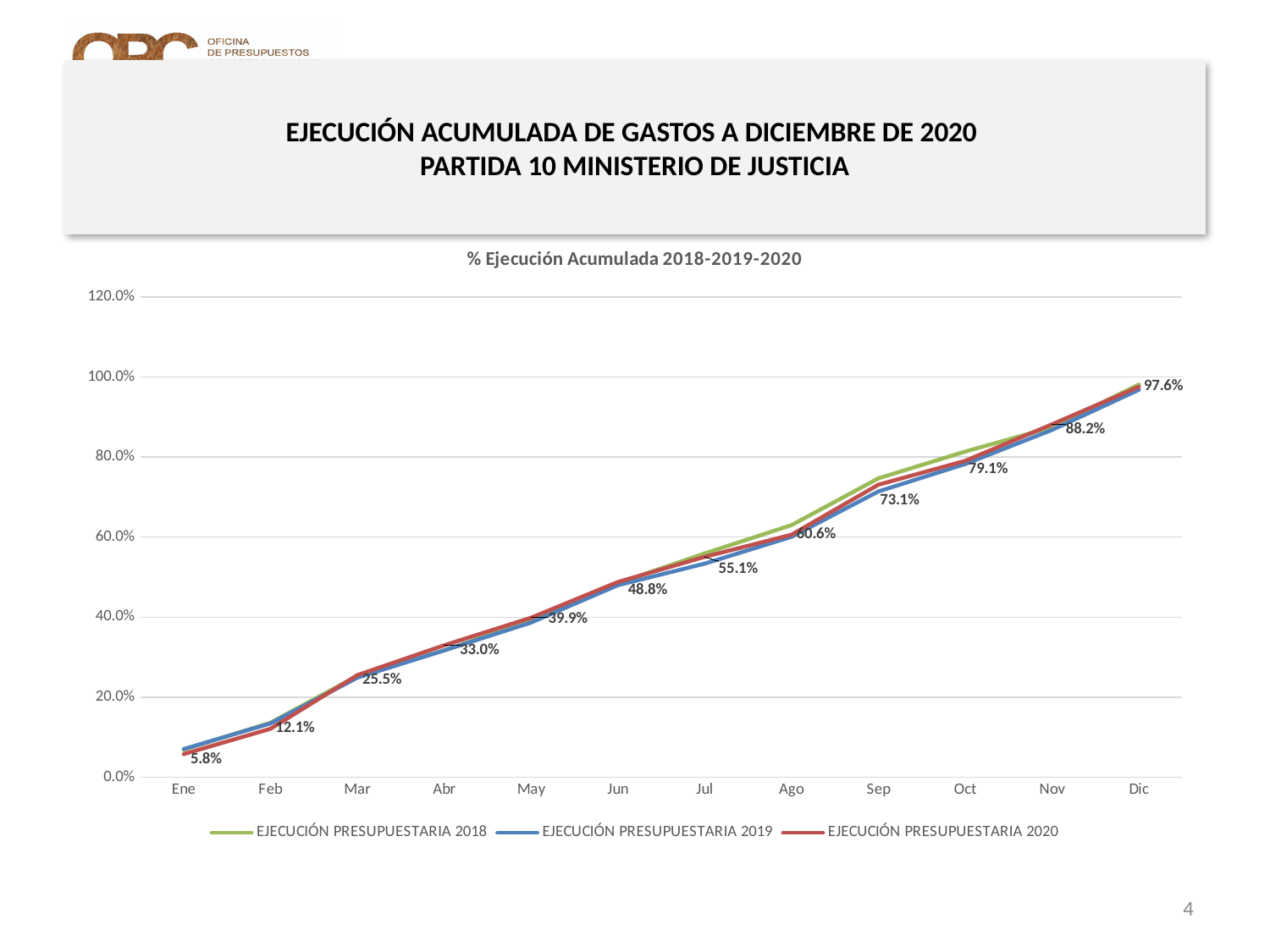
What is the data label shown at Dic? 97.6% How many series does the legend list? 3 How many months are shown along the x axis? 12 Which month has the lowest labelled value? Ene What kind of chart is shown on the slide? line chart What is the data label shown at Jun? 48.8% What is the data label shown at Sep? 73.1% What is the data label shown at Ene? 5.8% Do the values rise or fall from Ene to Dic? rise What is the difference between the labelled values at Dic and Nov? 9.4% What is the title of the chart? % Ejecución Acumulada 2018-2019-2020 Which month has the highest labelled value? Dic